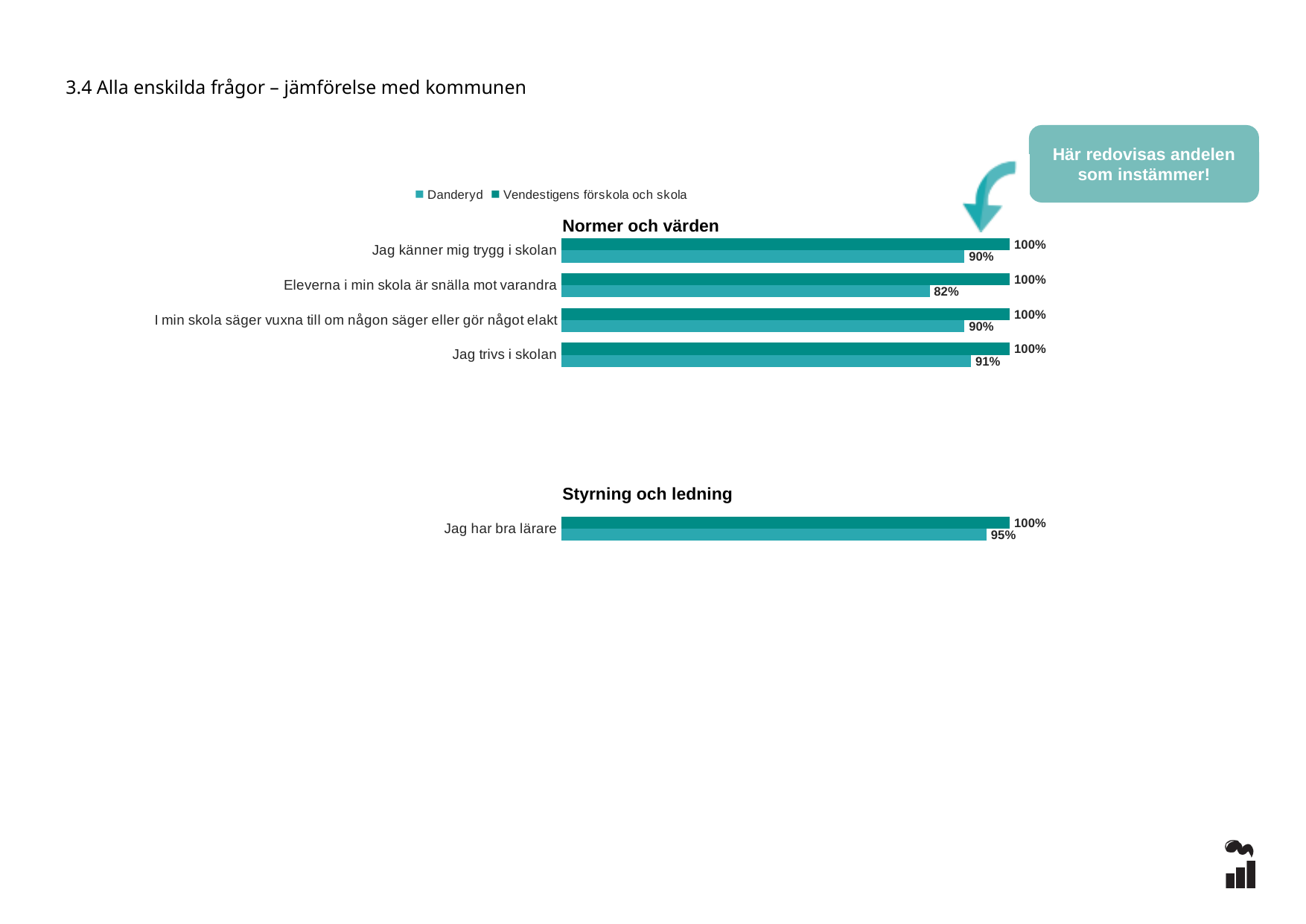
What type of chart is the 'Styrning och ledning' chart? Bar chart In the 'Styrning och ledning' chart, what is the value for Danderyd for 'Jag har bra lärare'? 95% In the 'Normer och värden' chart, what is the difference between Vendestigens förskola och skola and Danderyd for 'Eleverna i min skola är snälla mot varandra'? 18% In the 'Styrning och ledning' chart, what is the difference between Vendestigens förskola och skola and Danderyd for 'Jag har bra lärare'? 5% In the 'Normer och värden' chart, which category has the lowest value for Danderyd? Eleverna i min skola är snälla mot varandra How many categories are shown in the 'Normer och värden' chart? 4 In the 'Normer och värden' chart, what is the value for Danderyd for 'Jag känner mig trygg i skolan'? 90% In the 'Normer och värden' chart, which is larger for 'Jag trivs i skolan': Danderyd or Vendestigens förskola och skola? Vendestigens förskola och skola How many series does the legend list? 2 In the 'Normer och värden' chart, what is the value for Danderyd for 'Eleverna i min skola är snälla mot varandra'? 82% In the 'Normer och värden' chart, which category has the highest value for Danderyd? Jag trivs i skolan In the 'Normer och värden' chart, what is the value for Vendestigens förskola och skola for 'Jag trivs i skolan'? 100%